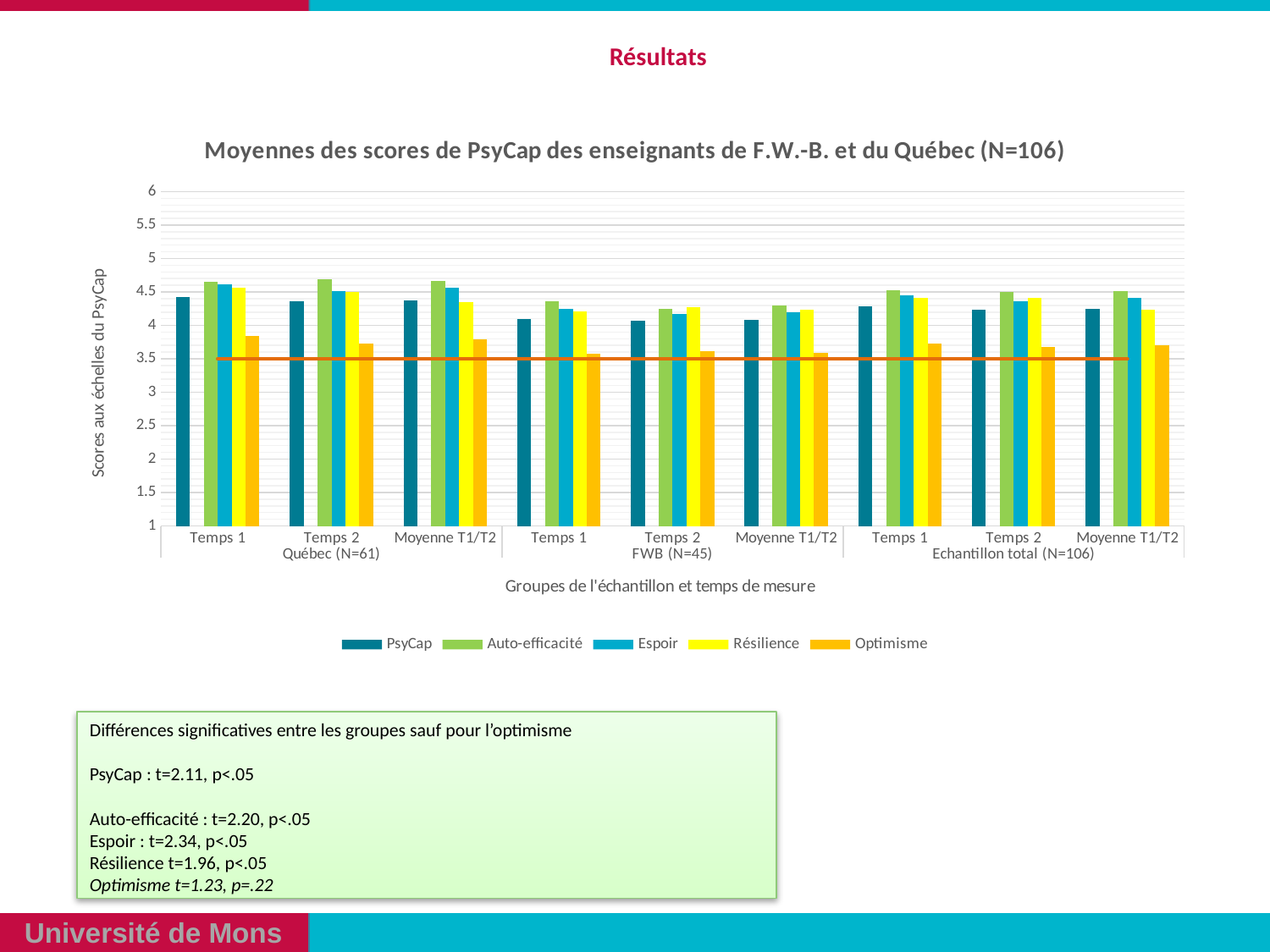
What kind of chart is shown on the slide? Bar chart What is the label of the vertical axis of the chart? Scores aux échelles du PsyCap Which is larger: the PsyCap value for Temps 1 in the Québec (N=61) group or the PsyCap value for Temps 1 in the FWB (N=45) group? Québec (N=61) Temps 1 Is the Optimisme value for Temps 1 in the Québec (N=61) group greater or less than 3.5? greater Is the Espoir value for Temps 2 in the FWB (N=45) group greater or less than 4.5? less How many series does the chart legend list? 5 Is the Optimisme value for Temps 2 in the Québec (N=61) group greater or less than 4? less How many category groups are shown along the x axis of the chart? 9 Which series has the highest value for Temps 2 in the Québec (N=61) group? Auto-efficacité What is the title of the chart? Moyennes des scores de PsyCap des enseignants de F.W.-B. et du Québec (N=106) Which series has the lowest value for Temps 1 in the Québec (N=61) group? Optimisme